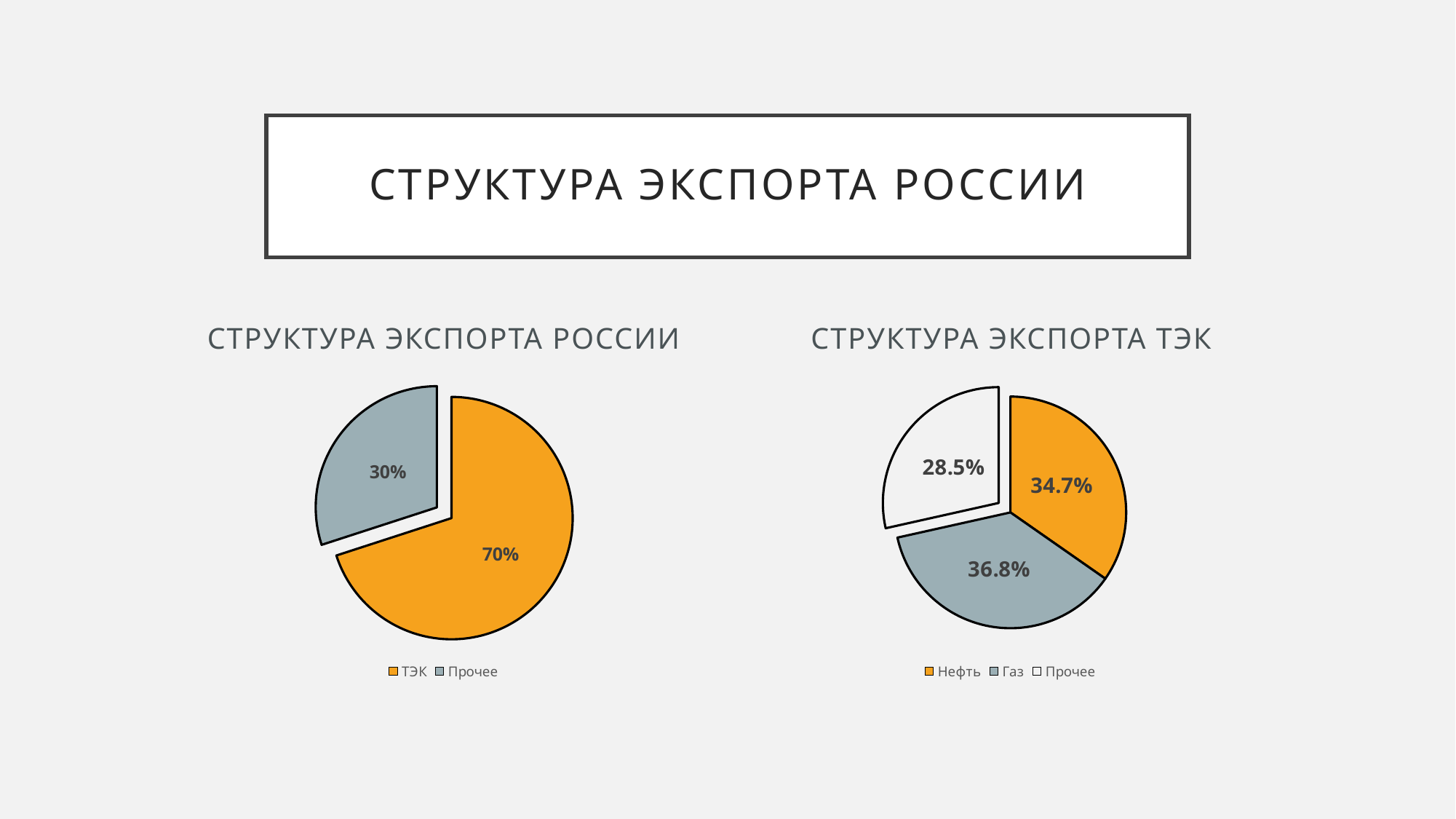
In the chart titled 'СТРУКТУРА ЭКСПОРТА ТЭК', which category has the smallest share? Прочее In the chart titled 'СТРУКТУРА ЭКСПОРТА ТЭК', which is larger, Нефть or Прочее? Нефть In the chart titled 'СТРУКТУРА ЭКСПОРТА ТЭК', what is the difference between the Газ and Нефть shares? 2.1% In the chart titled 'СТРУКТУРА ЭКСПОРТА РОССИИ', what is the value for ТЭК? 70% In the chart titled 'СТРУКТУРА ЭКСПОРТА ТЭК', what is the value for Прочее? 28.5% In the chart titled 'СТРУКТУРА ЭКСПОРТА ТЭК', what is the value for Газ? 36.8% In the chart titled 'СТРУКТУРА ЭКСПОРТА ТЭК', what is the value for Нефть? 34.7% In the chart titled 'СТРУКТУРА ЭКСПОРТА РОССИИ', what is the value for Прочее? 30% What kind of chart is the chart titled 'СТРУКТУРА ЭКСПОРТА РОССИИ'? Pie chart In the chart titled 'СТРУКТУРА ЭКСПОРТА ТЭК', which category has the largest share? Газ How many categories does the legend of the chart titled 'СТРУКТУРА ЭКСПОРТА ТЭК' list? 3 In the chart titled 'СТРУКТУРА ЭКСПОРТА РОССИИ', what is the difference between the ТЭК and Прочее shares? 40%